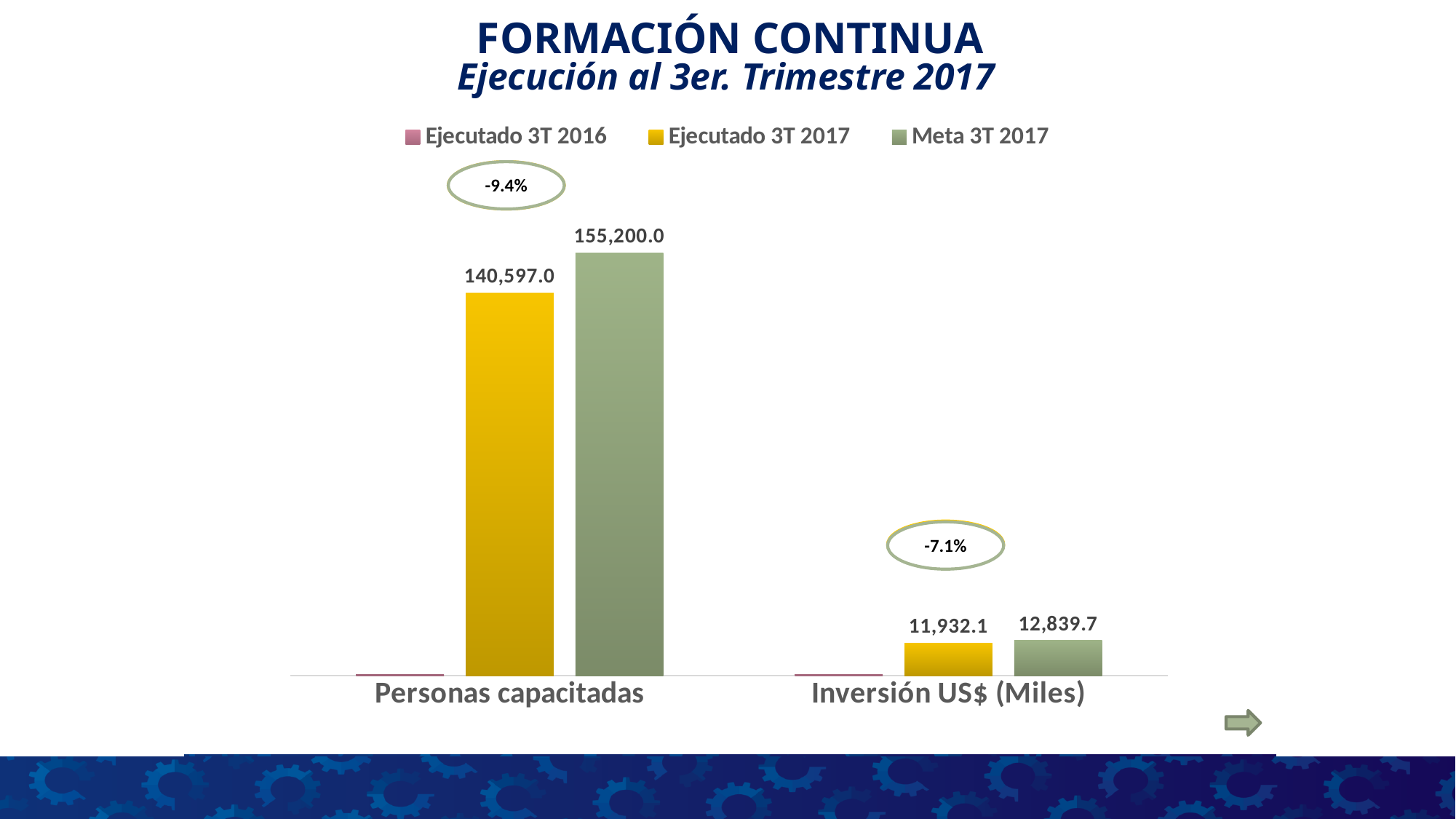
How many categories are shown on the x axis? 2 What percentage is shown in the oval annotation above the Personas capacitadas bars? -9.4% How many series does the legend list? 3 What is the difference between Meta 3T 2017 and Ejecutado 3T 2017 for Inversión US$ (Miles)? 907.6 Which category has the highest Meta 3T 2017 value? Personas capacitadas What is the difference between Meta 3T 2017 and Ejecutado 3T 2017 for Personas capacitadas? 14,603.0 What is the value of Meta 3T 2017 for Inversión US$ (Miles)? 12,839.7 What is the value of Meta 3T 2017 for Personas capacitadas? 155,200.0 What is the value of Ejecutado 3T 2017 for Personas capacitadas? 140,597.0 For Personas capacitadas, which is larger: Ejecutado 3T 2017 or Meta 3T 2017? Meta 3T 2017 What kind of chart is shown on the slide? Bar chart What is the value of Ejecutado 3T 2017 for Inversión US$ (Miles)? 11,932.1